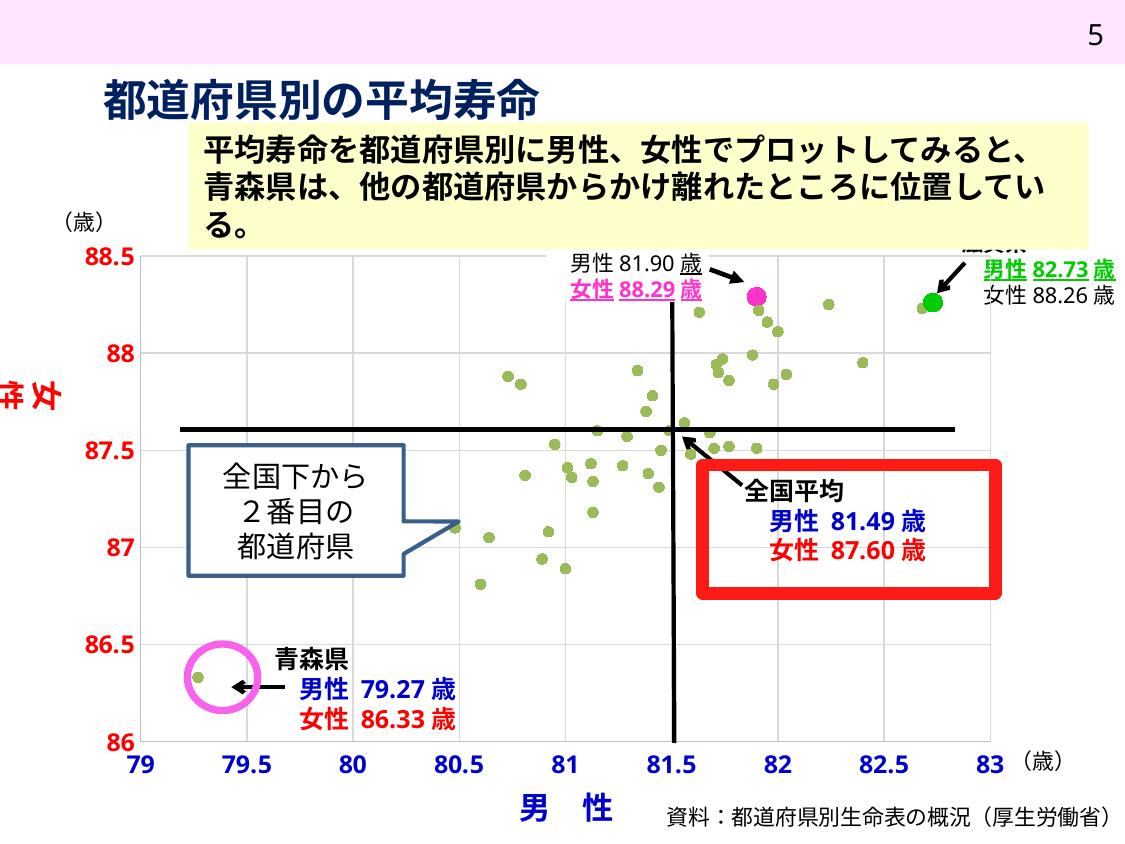
What is the male life expectancy labelled for the green point on the chart? 82.73歳 What is the male life expectancy (男性) for 青森県 shown on the chart? 79.27歳 What is the female life expectancy (女性) for 青森県 shown on the chart? 86.33歳 What is the national average (全国平均) male life expectancy shown on the chart? 81.49歳 Which prefecture is labelled as the lowest point on the chart, far from the others? 青森県 What is the national average (全国平均) female life expectancy shown on the chart? 87.60歳 What kind of chart is shown on the slide? scatter plot What is the female life expectancy labelled for the pink (magenta) point on the chart? 88.29歳 Is the female life expectancy for 青森県 greater or less than 86.5? less How much higher is the national average female life expectancy than that of 青森県? 1.27歳 Which has the higher male life expectancy, the green point or the pink point? the green point How much higher is the national average male life expectancy than that of 青森県? 2.22歳